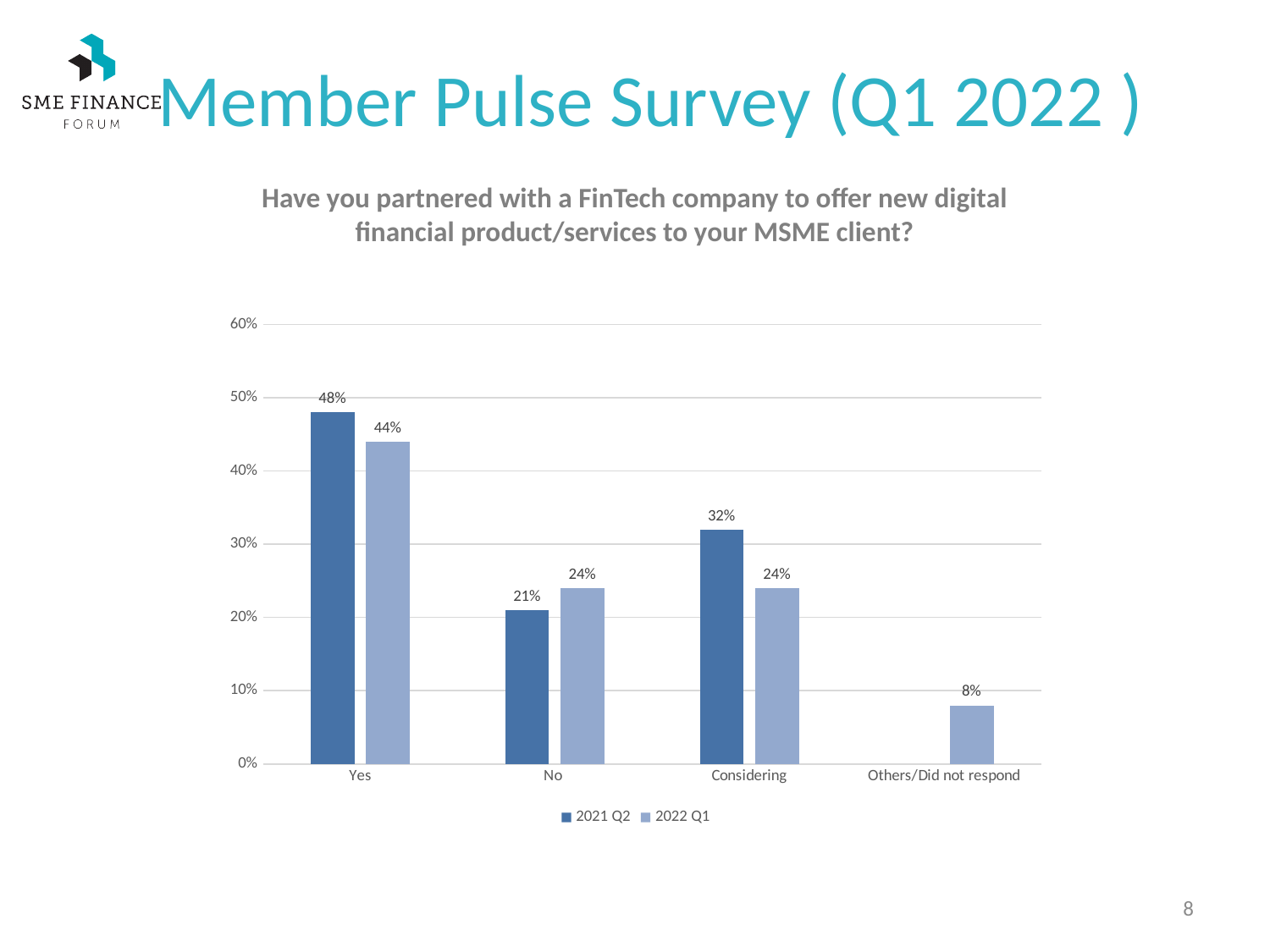
How many categories are shown on the x axis? 4 For 'No', which series has the larger value, 2021 Q2 or 2022 Q1? 2022 Q1 What is the difference between the 'Yes' values for 2021 Q2 and 2022 Q1? 4% What is the value for 'Others/Did not respond' in the 2022 Q1 series? 8% How many series does the legend list? 2 What is the value for 'Yes' in the 2021 Q2 series? 48% What is the value for 'Considering' in the 2022 Q1 series? 24% Which category has the lowest value in the 2022 Q1 series? Others/Did not respond What kind of chart is shown on the slide? Bar chart What is the difference between the 2021 Q2 and 2022 Q1 values for 'Considering'? 8% Which category has the highest value in the 2021 Q2 series? Yes What are the two series listed in the legend? 2021 Q2 and 2022 Q1